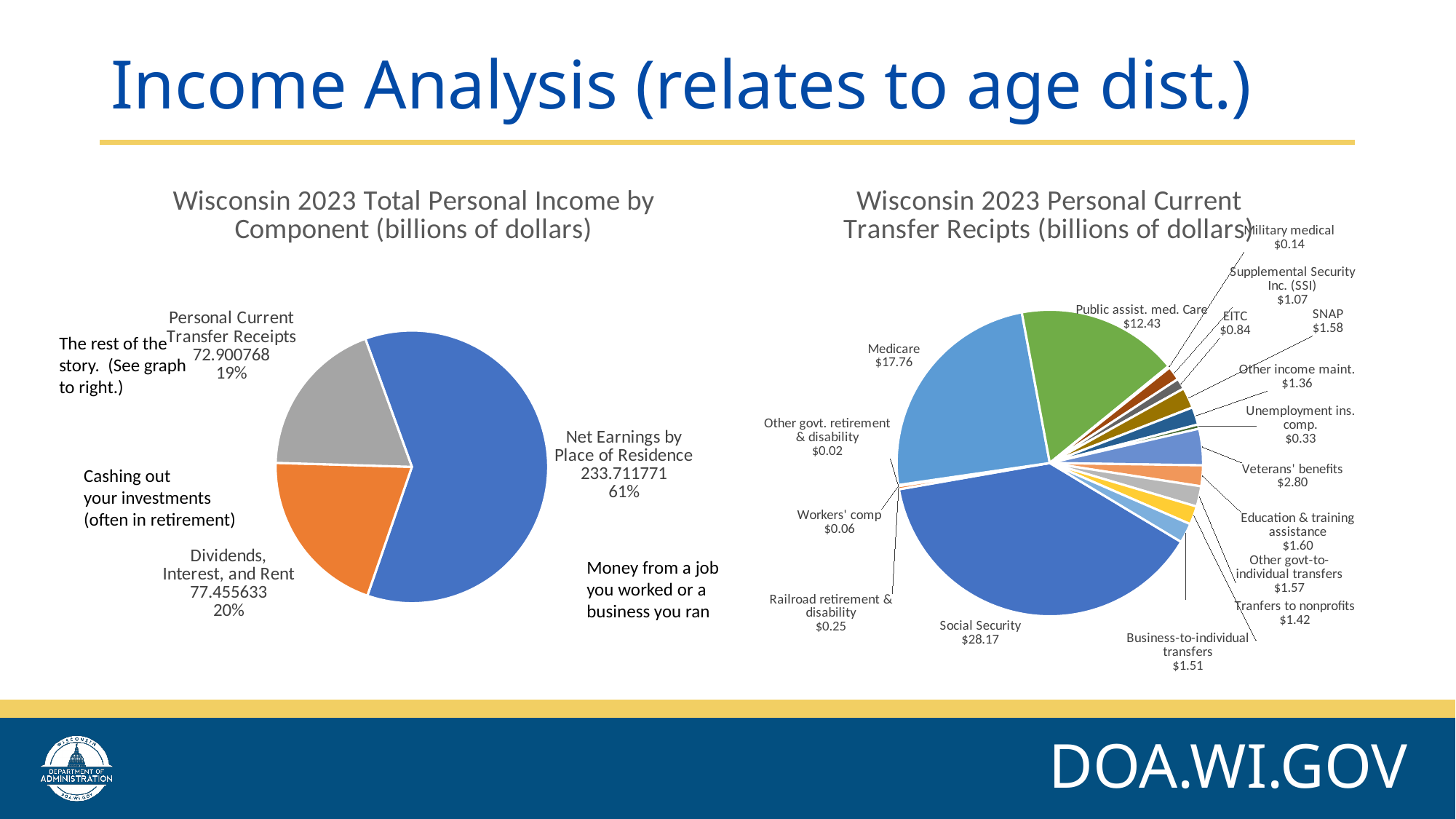
On the right chart, which category has the smallest value? Other govt. retirement & disability On the right chart, what value is shown for Public assist. med. Care? $12.43 On the right chart, what is the difference between Social Security and Medicare? $10.41 On the right chart, what value is shown for Medicare? $17.76 On the left chart, which component is the largest? Net Earnings by Place of Residence On the left chart, what share of the pie is Personal Current Transfer Receipts? 19% How many slices does the left chart (Total Personal Income by Component) have? 3 What kind of chart is the Wisconsin 2023 Personal Current Transfer Receipts chart? Pie chart On the left chart, what share of the pie is Dividends, Interest, and Rent? 20% On the right chart, what value is shown for Social Security? $28.17 On the left chart, what value is shown for Net Earnings by Place of Residence? 233.711771 On the right chart, which is larger: Veterans' benefits or SNAP? Veterans' benefits